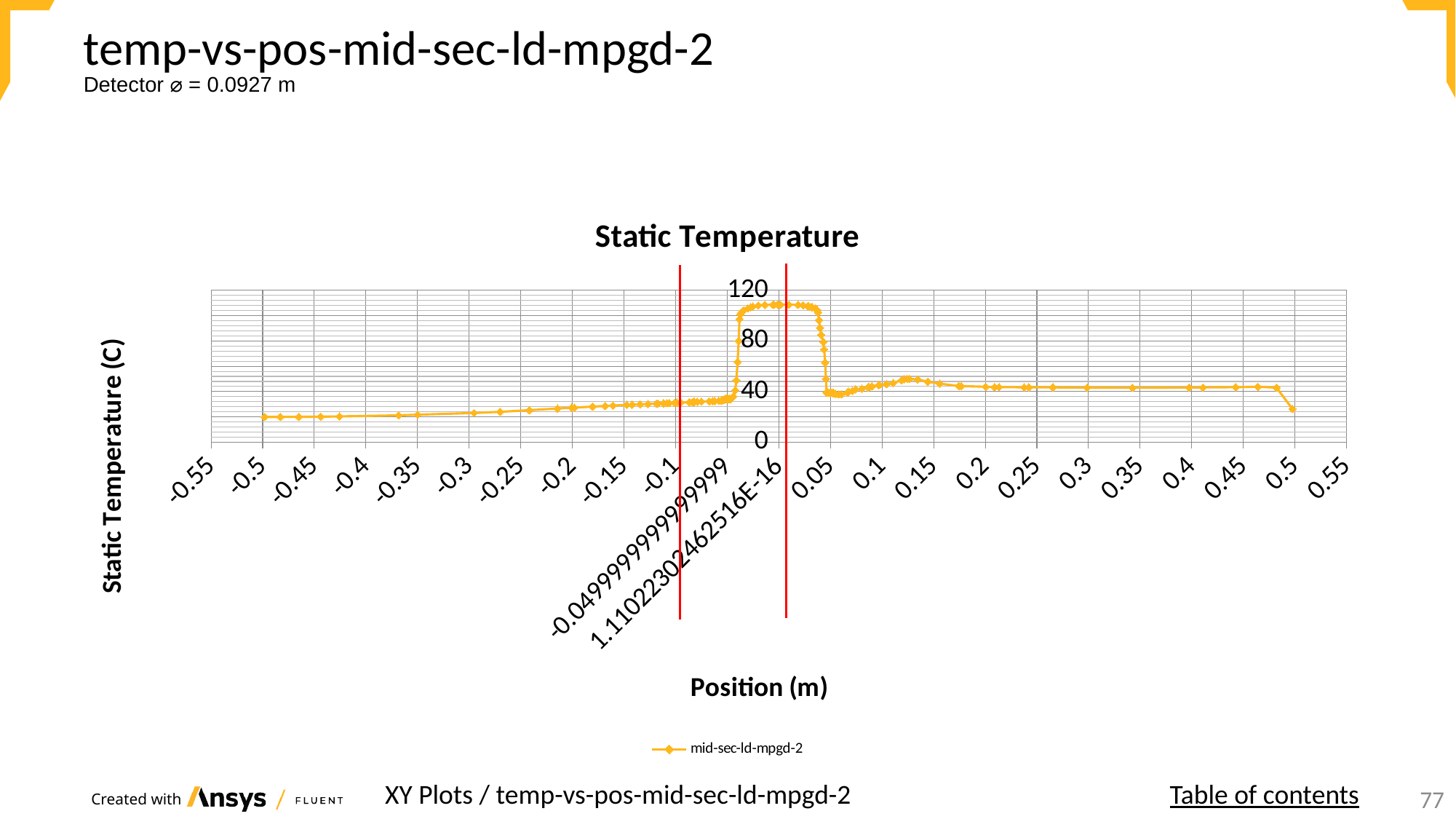
Is the value for position -0.5 greater or less than 40? less Do the values rise or fall along the x axis between position -0.5 and -0.1? rise Is the value for position -0.3 greater or less than 40? less Is the value for position 0.1 greater or less than 80? less What kind of chart is shown on the slide? line chart How many series does the legend list? 1 In which region of the x axis does the series reach its highest values: between the two red vertical lines, or to the right of them? between the two red vertical lines What is the name of the series in the legend? mid-sec-ld-mpgd-2 What is the highest tick value shown on the y axis? 120 What is the title of the chart? Static Temperature Is the value at position -0.5 larger or smaller than the value at position 0.3? smaller